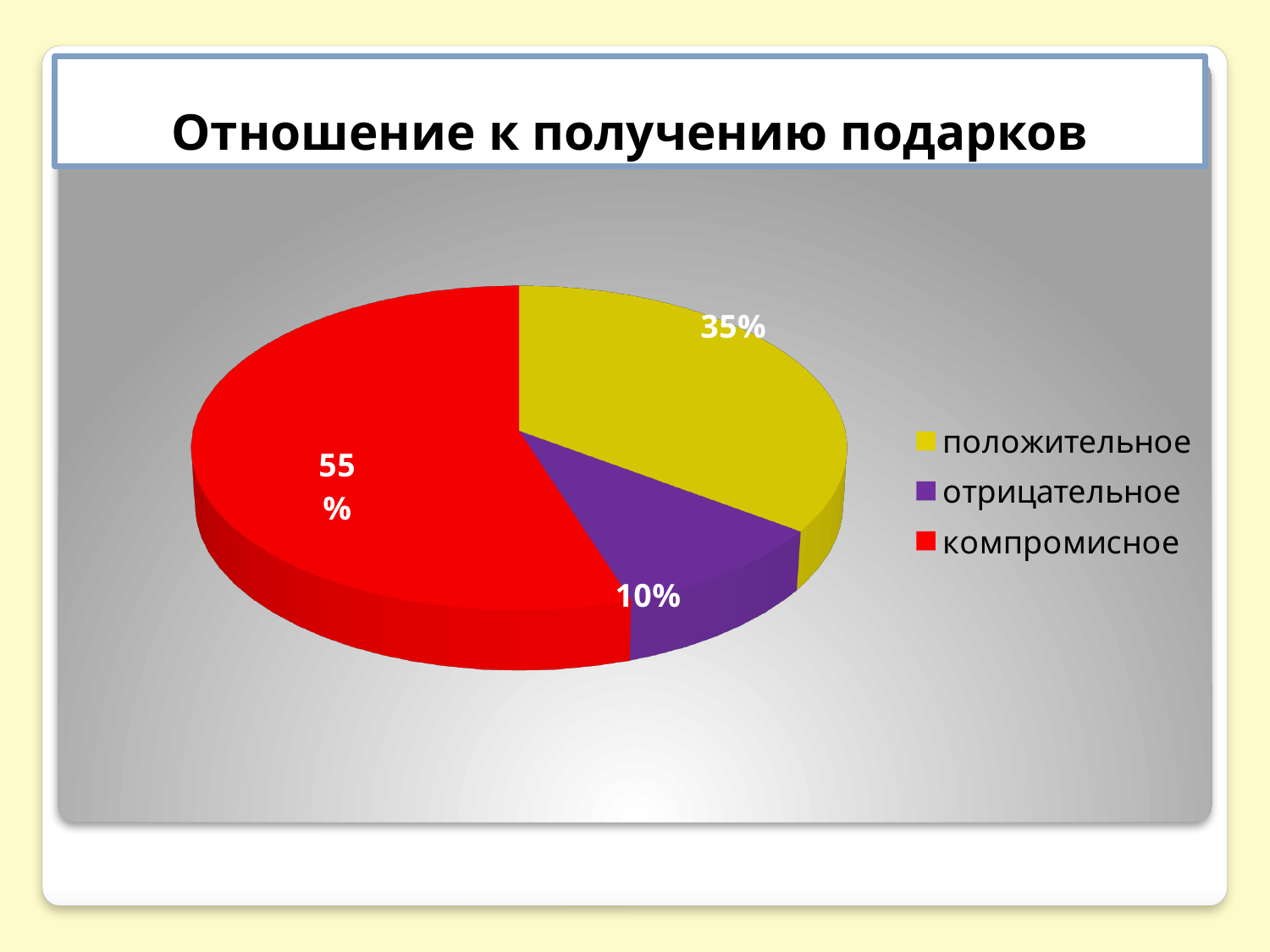
What share of the pie does the 'отрицательное' slice represent? 10% What is the title of the chart? Отношение к получению подарков What share of the pie does the 'компромисное' slice represent? 55% Which category has the smallest share of the pie? отрицательное What is the difference in percentage points between 'положительное' and 'отрицательное'? 25 How many categories does the pie chart show? 3 What share of the pie does the 'положительное' slice represent? 35% What colour is the 'отрицательное' slice? purple Which is larger, the share for 'положительное' or for 'отрицательное'? положительное What is the difference in percentage points between 'компромисное' and 'положительное'? 20 Which category has the largest share of the pie? компромисное What kind of chart is shown on the slide? pie chart